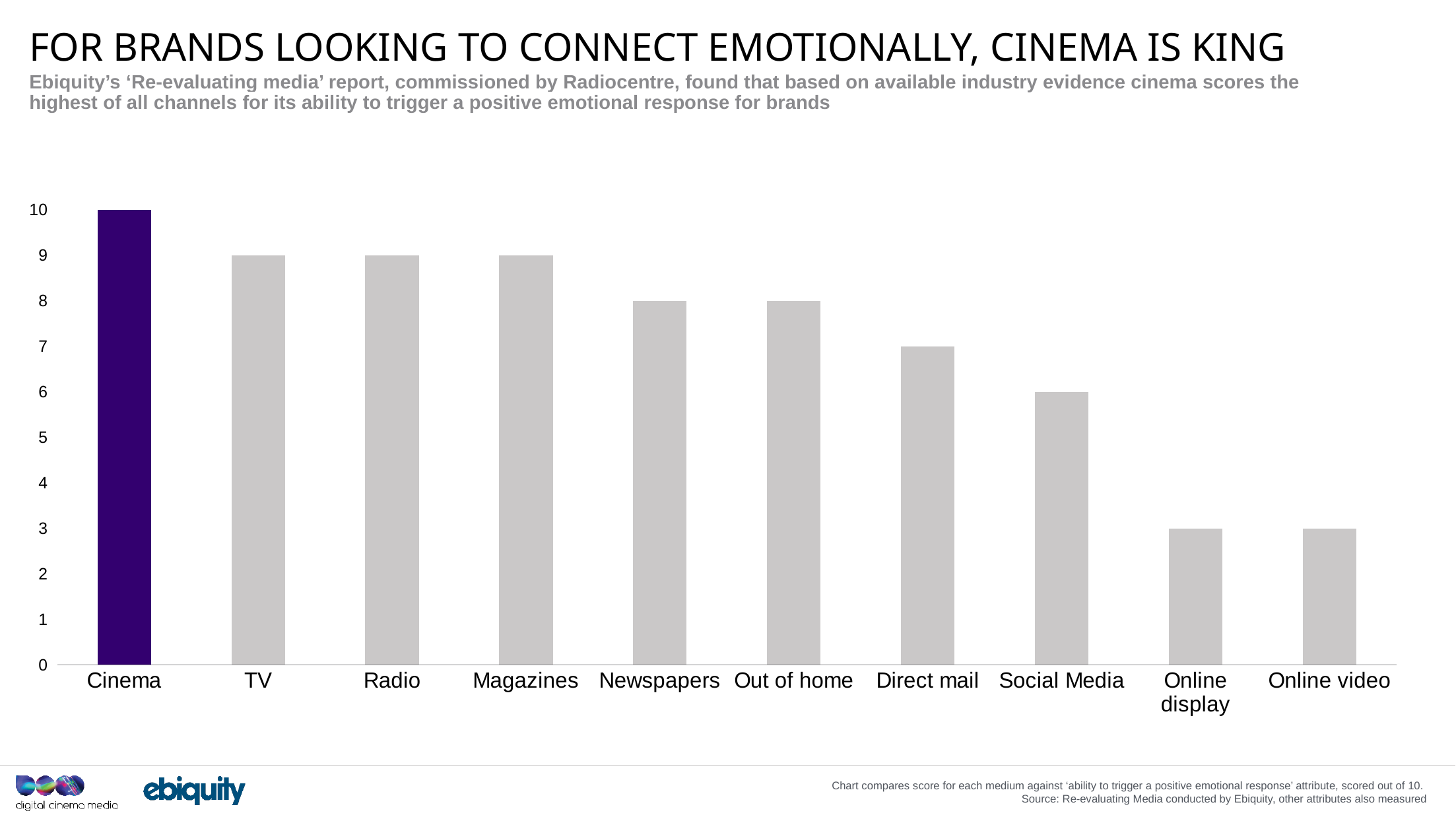
Which is larger, the value for Magazines or the value for Out of home? Magazines Which bar is coloured differently from the others? Cinema What is the value for Direct mail? 7 Which category has the highest value? Cinema Is the value for Direct mail greater or less than 5? greater How many categories are shown on the x axis? 10 What is the value for Newspapers? 8 What is the difference between the values for TV and Online display? 6 What kind of chart is shown on the slide? bar chart What is the value for Cinema? 10 What is the value for Social Media? 6 What is the difference between the values for Cinema and Social Media? 4